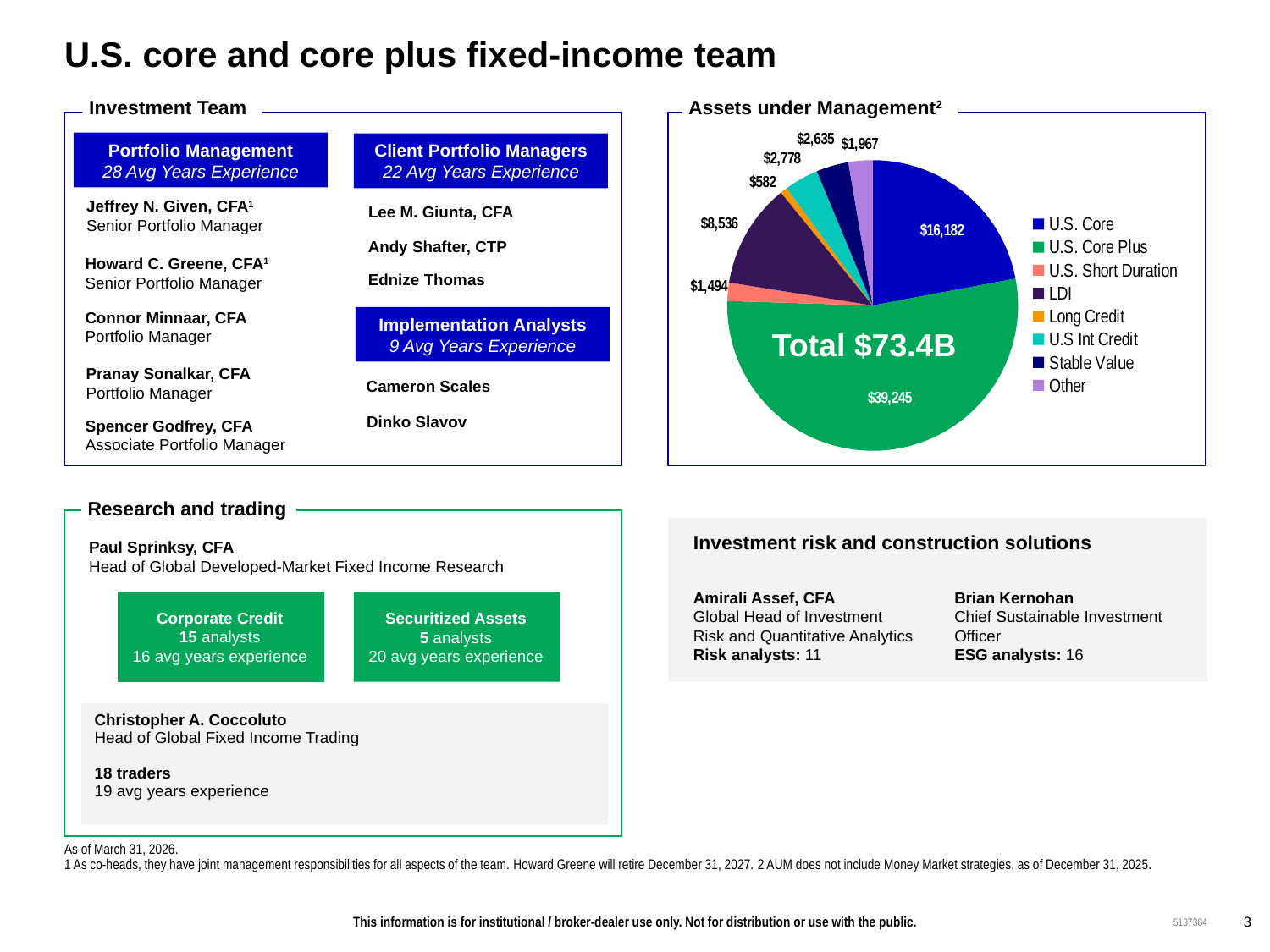
Which category has the smallest slice in the Assets under Management pie chart? Long Credit What total is printed in the centre of the Assets under Management pie chart? Total $73.4B How many categories does the legend of the Assets under Management pie chart list? 8 In the Assets under Management pie chart, what is the difference between U.S. Core Plus and U.S. Core? $23,063 In the Assets under Management pie chart, what is the value for U.S. Core Plus? $39,245 What type of chart is shown under Assets under Management? Pie chart In the Assets under Management pie chart, what is the value for U.S. Short Duration? $1,494 In the Assets under Management pie chart, what is the value for LDI? $8,536 Which category has the largest slice in the Assets under Management pie chart? U.S. Core Plus In the Assets under Management pie chart, which is larger: LDI or U.S Int Credit? LDI In the Assets under Management pie chart, what is the value for Long Credit? $582 In the Assets under Management pie chart, what is the value for U.S. Core? $16,182